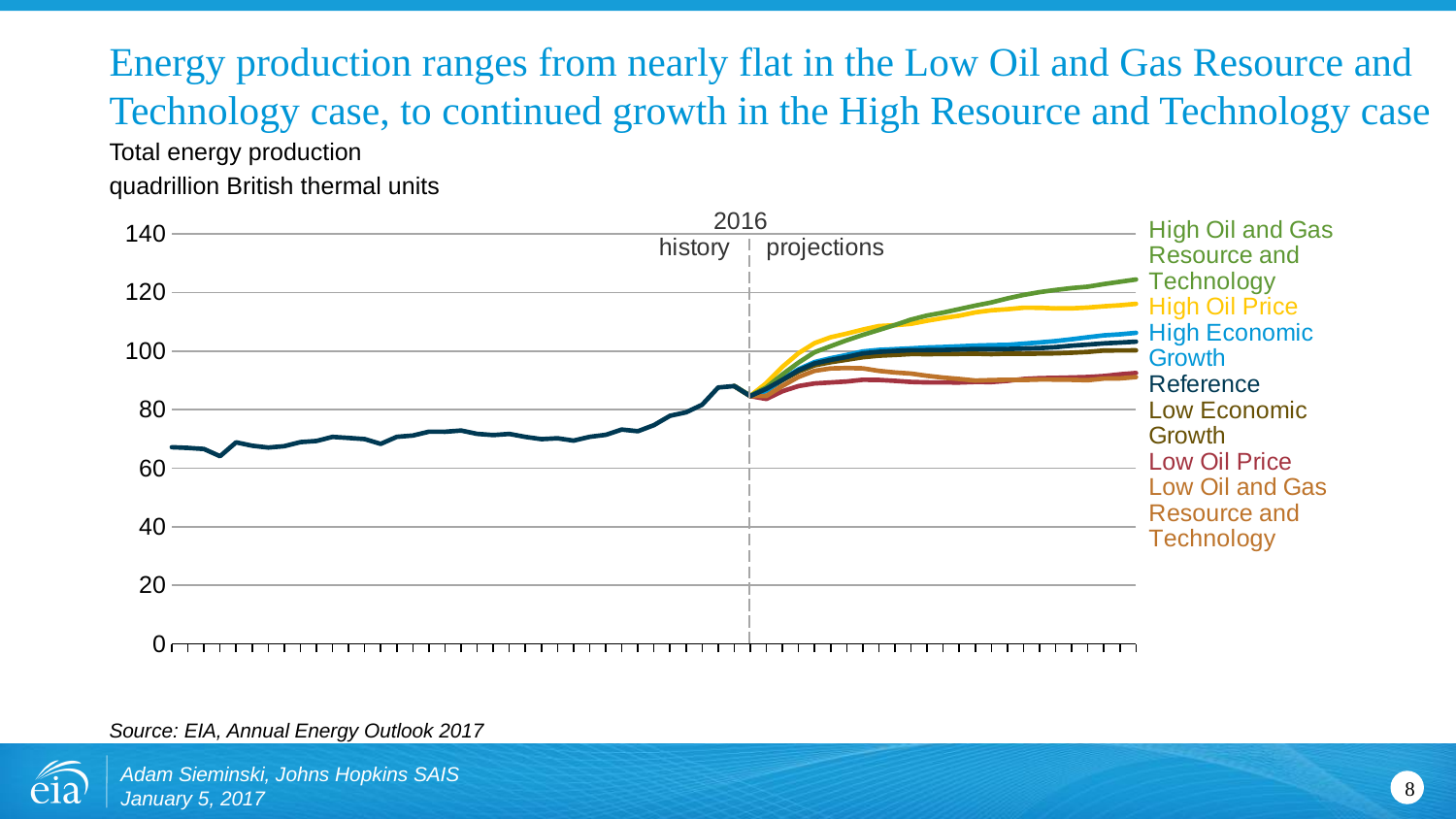
At the end of the projection period, is the value for Low Oil and Gas Resource and Technology greater or less than 100? less What year separates history from projections on the chart? 2016 At the end of the projection period, is the value for Low Oil Price greater or less than 100? less What kind of chart is shown on the slide? line chart At the end of the projection period, which is larger: High Oil Price or Reference? High Oil Price At the end of the projection period, which is larger: High Economic Growth or Low Economic Growth? High Economic Growth At the end of the projection period, is the value for High Oil and Gas Resource and Technology greater or less than 100? greater How many scenario series are labelled on the chart? 7 Over the history period, does total energy production generally rise or fall? rise Which series has the highest value at the end of the projection period? High Oil and Gas Resource and Technology What unit is total energy production measured in on the chart? quadrillion British thermal units